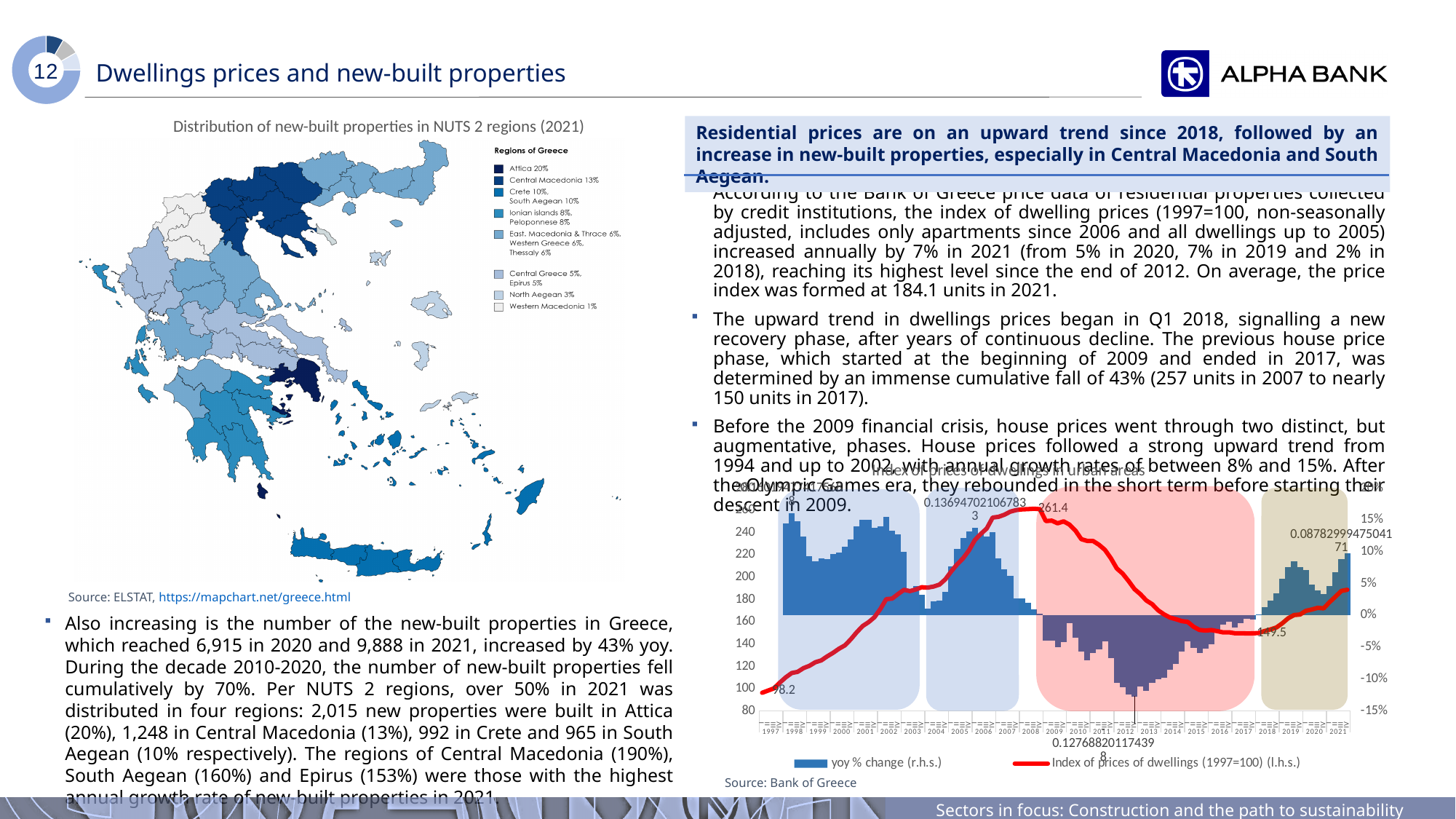
In the 'Index of prices of dwellings in urban areas' chart, what is the difference between the labelled peak value 261.4 and the 1997 value 98.2? 163.2 How many series does the legend of the 'Index of prices of dwellings in urban areas' chart list? 2 In the 'Index of prices of dwellings in urban areas' chart, is the yoy % change bar in 2012 greater or less than -10%? less In the 'Index of prices of dwellings in urban areas' chart, what value is labelled on the index line at its start in 1997? 98.2 In the 'Index of prices of dwellings in urban areas' chart, which is larger: the index value labelled 261.4 around 2008 or the value labelled 149.5 around 2017? 261.4 around 2008 In the 'Index of prices of dwellings in urban areas' chart, is the index value at the end of 2021 greater or less than 160? greater In the 'Index of prices of dwellings in urban areas' chart, what is the difference between the labelled peak value 261.4 and the labelled low value 149.5? 111.9 In the 'Index of prices of dwellings in urban areas' chart, what is the peak value labelled on the index line? 261.4 What kind of chart is the 'Index of prices of dwellings in urban areas' chart? A combination bar and line chart In the 'Index of prices of dwellings in urban areas' chart, what value is labelled on the index line at its low point around 2017? 149.5 What are the two legend entries of the 'Index of prices of dwellings in urban areas' chart? yoy % change (r.h.s.) and Index of prices of dwellings (1997=100) (l.h.s.) In the 'Index of prices of dwellings in urban areas' chart, does the index line rise or fall between 2009 and 2017? Falls